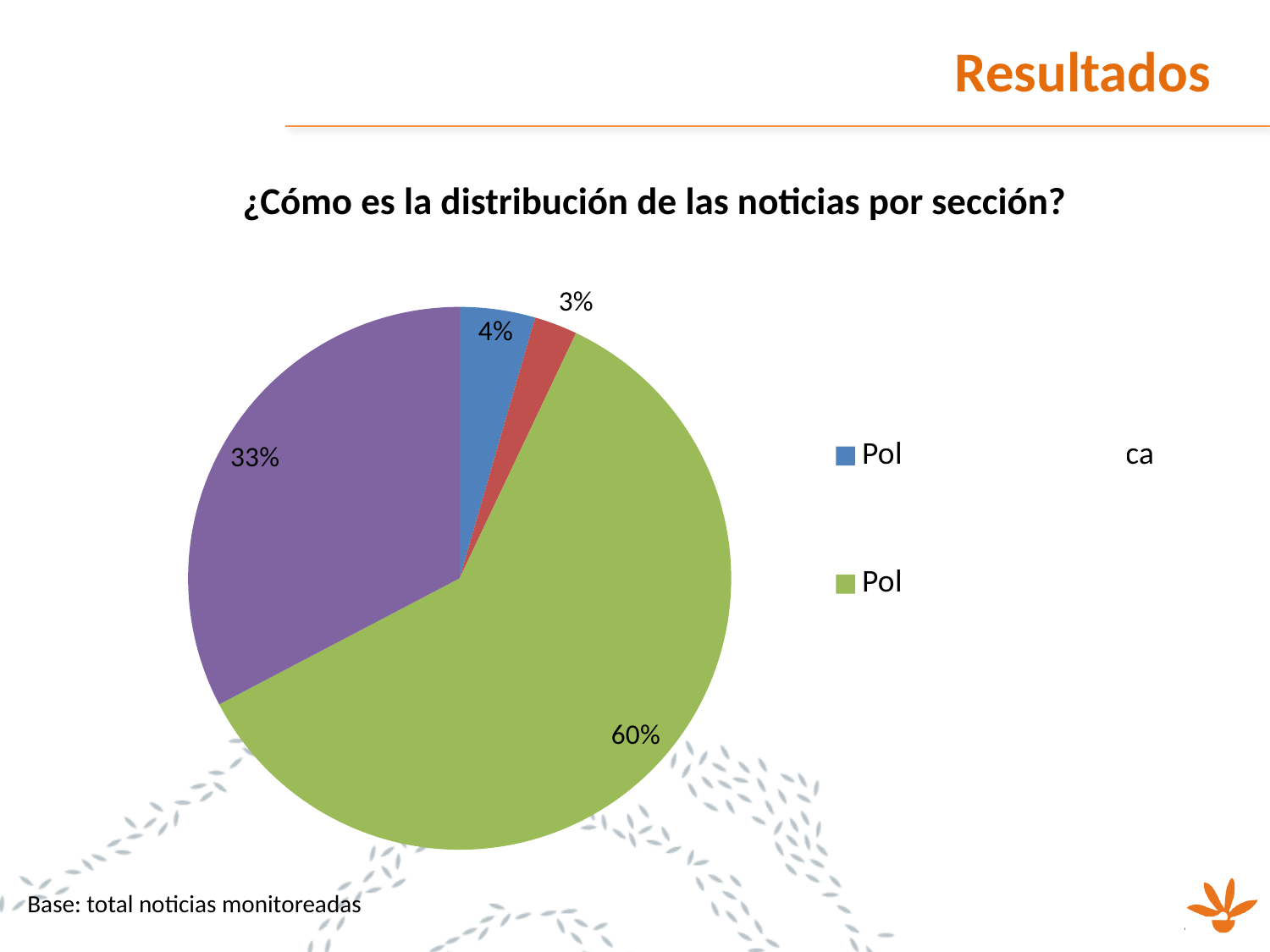
What percentage is shown for the purple slice of the pie chart? 33% Which slice is larger, the blue slice or the red slice? the blue slice What is the difference between the green slice (60%) and the purple slice (33%)? 27% What is the title of the chart on the slide? ¿Cómo es la distribución de las noticias por sección? Which colour is the largest slice of the pie chart? green What is the value of the smallest slice of the pie chart? 3% What is the value of the largest slice of the pie chart? 60% What percentage is shown for the green slice of the pie chart? 60% What percentage is shown for the red slice of the pie chart? 3% What kind of chart is shown on the slide? pie chart What percentage is shown for the blue slice of the pie chart? 4% How many slices does the pie chart have? 4